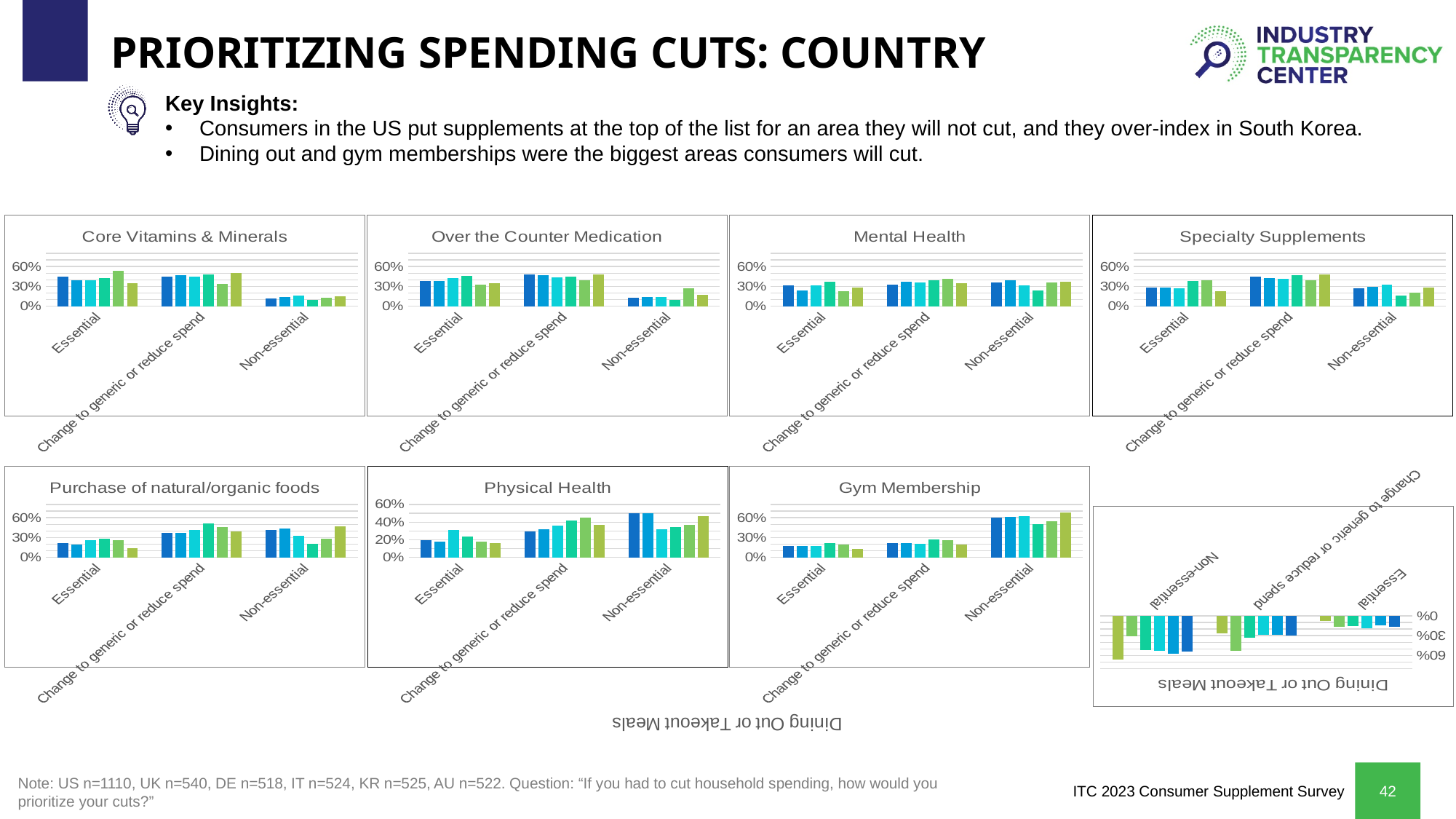
How many bars are in each category group of the "Mental Health" chart? 6 How many charts are shown on the slide? 8 In the "Physical Health" chart, which category has the highest values? Non-essential In the "Core Vitamins & Minerals" chart, are the values for Non-essential greater or less than 30%? less In the "Gym Membership" chart, which category has the highest values? Non-essential In the "Gym Membership" chart, are the values for Non-essential greater or less than 30%? greater How many categories are shown on the x axis of the "Gym Membership" chart? 3 In the "Core Vitamins & Minerals" chart, which category has the lowest values? Non-essential What kind of chart is the "Core Vitamins & Minerals" chart? bar chart In the "Physical Health" chart, are the values for Essential greater or less than 40%? less In the "Purchase of natural/organic foods" chart, which category has the lowest values? Essential In the "Gym Membership" chart, do the values rise or fall from Essential to Non-essential? rise